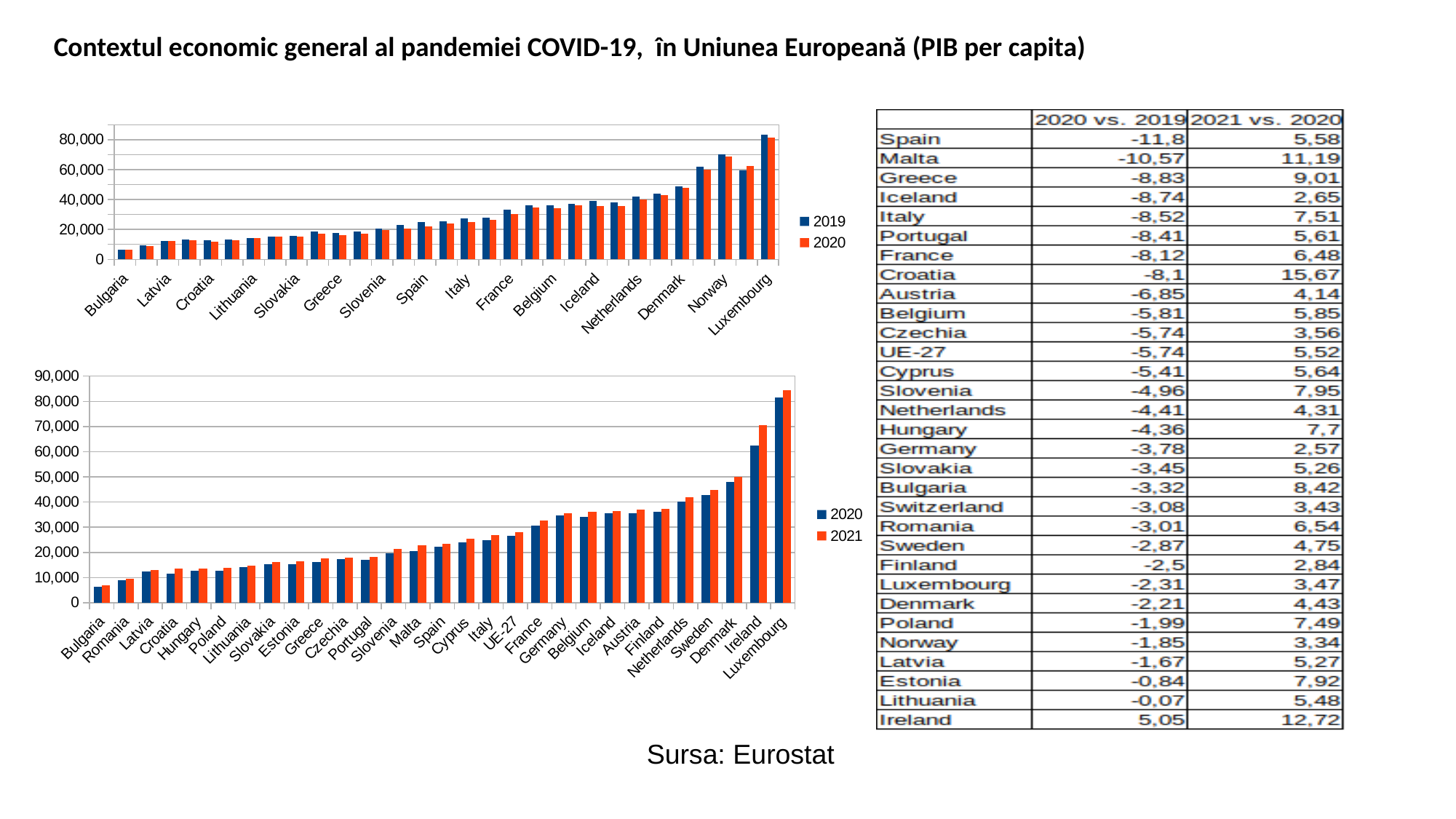
In the bottom chart, which country has the highest value for 2021? Luxembourg In the bottom chart, is the 2020 value for Bulgaria greater or less than 10,000? less In the top chart, is the 2020 value for Denmark greater or less than 60,000? less In the bottom chart, is the 2021 value for Luxembourg greater or less than 80,000? greater What kind of chart is the top chart on the slide? bar chart In the top chart, which colour represents the 2019 series? blue In the bottom chart, do the values generally rise or fall from left to right along the x axis? rise In the bottom chart, which country has the lowest value for 2020? Bulgaria How many series does the legend of the top chart list? 2 In the bottom chart, which is larger for 2021: Ireland or Denmark? Ireland Which two series does the legend of the bottom chart list? 2020 and 2021